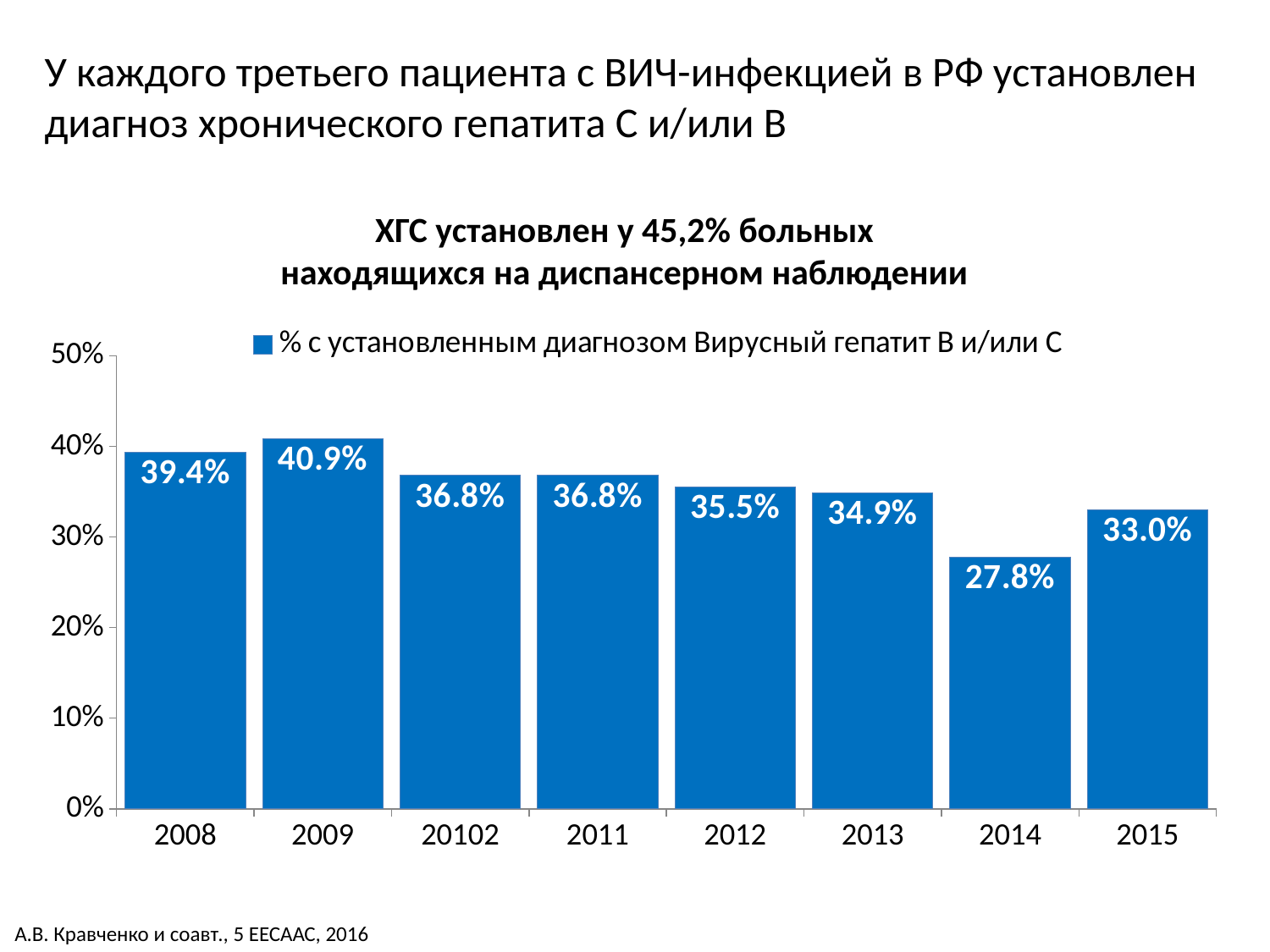
Is the value for 2013 greater or less than 30%? greater What kind of chart is shown on the slide? Bar chart Which is larger, the value for 2008 or the value for 2012? 2008 Which year has the lowest value? 2014 What is the value for 2015? 33.0% Which year has the highest value? 2009 What is the value for 2014? 27.8% What is the value for 2009? 40.9% How many series does the legend list? 1 How many bars are shown in the chart? 8 What is the difference between the values for 2009 and 2014? 13.1% What is the legend entry for the series? % с установленным диагнозом Вирусный гепатит В и/или С